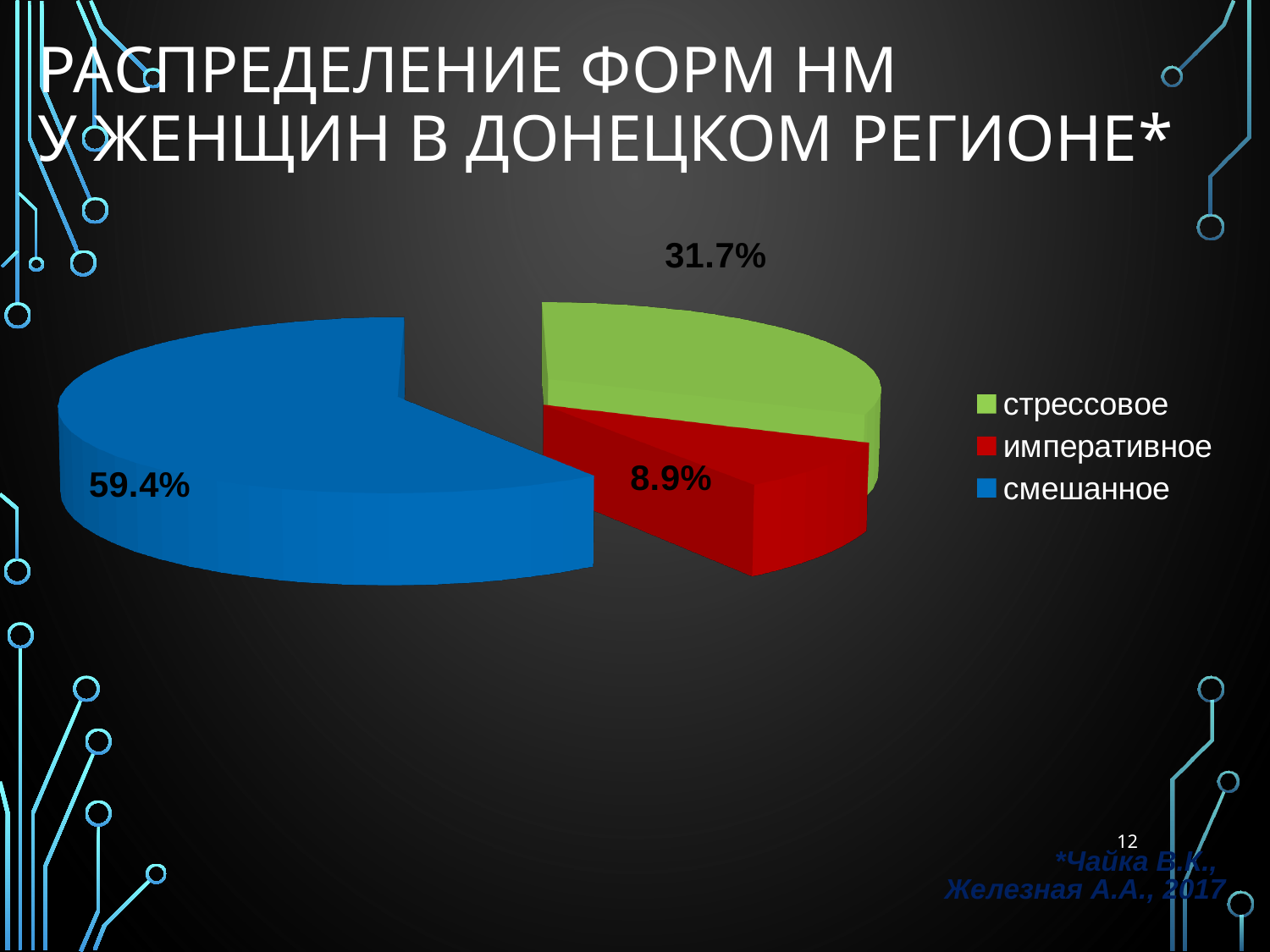
What is the difference between the shares of 'смешанное' and 'стрессовое'? 27.7% What kind of chart is shown on the slide? pie chart Which category has the largest slice of the pie? смешанное What colour is the 'смешанное' slice in the pie chart? blue What share of the pie does the 'императивное' slice represent? 8.9% Which category has the smallest slice of the pie? императивное How many entries does the legend list? 3 What share of the pie does the 'стрессовое' slice represent? 31.7% What is the difference between the shares of 'стрессовое' and 'императивное'? 22.8% What share of the pie does the 'смешанное' slice represent? 59.4% How many categories does the pie chart show? 3 Which is larger, the share of 'стрессовое' or the share of 'императивное'? стрессовое